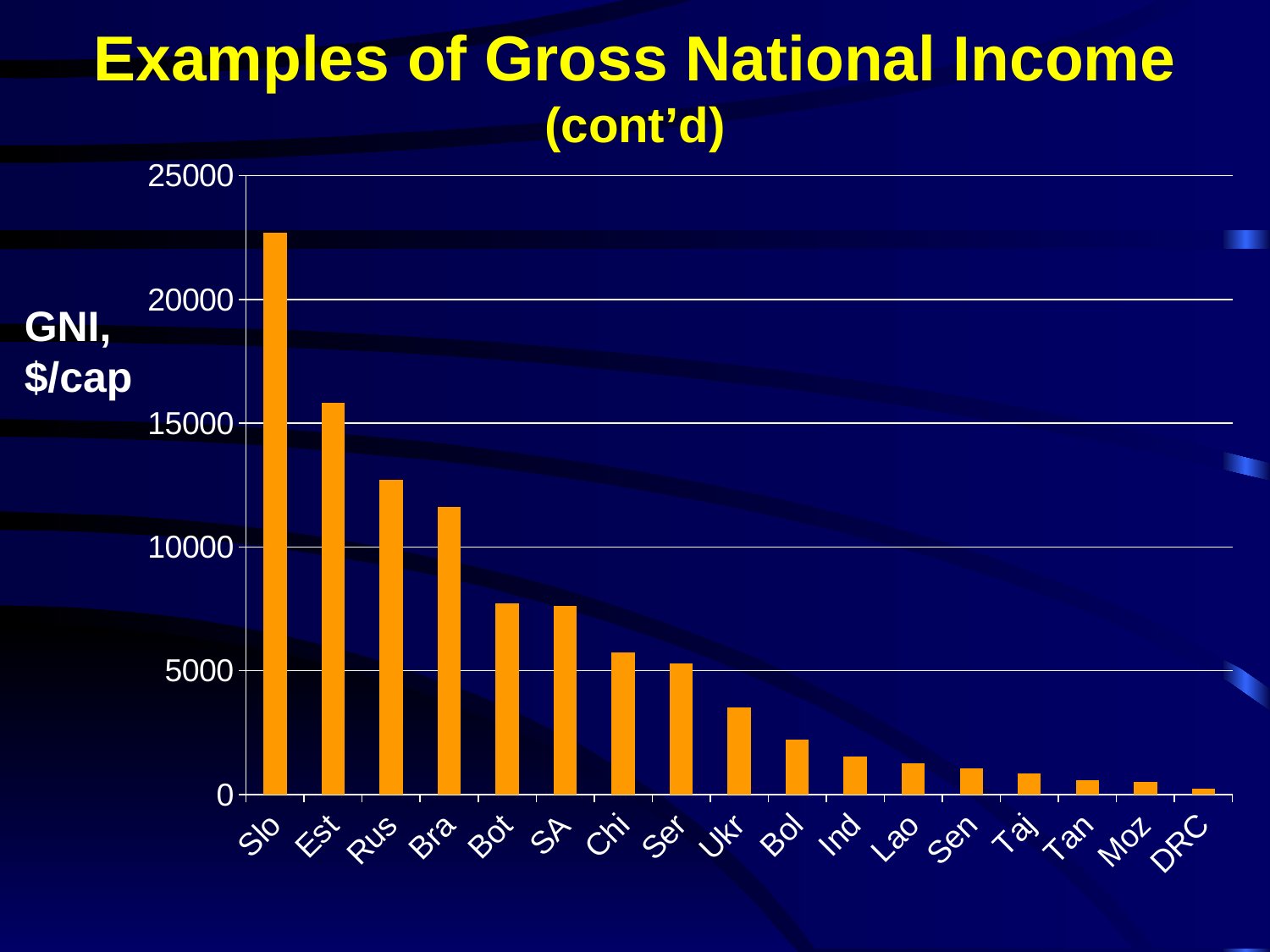
What is the label on the vertical axis of the chart? GNI, $/cap Do the values rise or fall moving from left to right along the x axis? fall Is the value for Ukr greater or less than 5000? less Is the value for Slo greater or less than 20000? greater Is the value for Bra greater or less than 10000? greater What kind of chart is shown on the slide? bar chart Which category has the lowest GNI per capita? DRC Which category has the highest GNI per capita? Slo How many categories are plotted on the x axis? 17 Which is larger, the value for Est or the value for Rus? Est